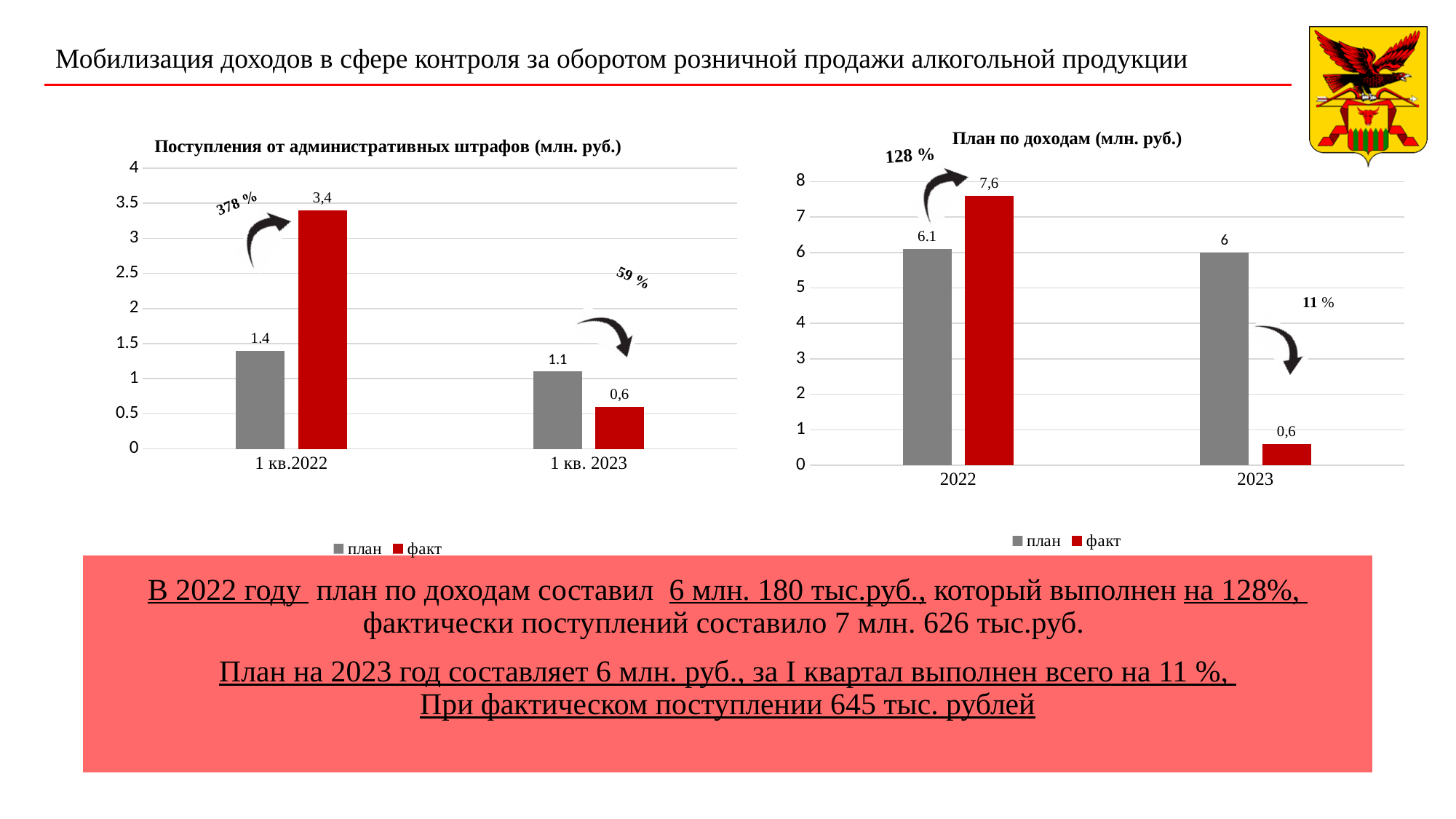
In the chart titled "План по доходам (млн. руб.)", how many categories are shown on the x axis? 2 In the chart titled "Поступления от административных штрафов (млн. руб.)", how many series does the legend list? 2 In the chart titled "План по доходам (млн. руб.)", what is the value of факт for 2022? 7,6 In the chart titled "Поступления от административных штрафов (млн. руб.)", what is the difference between факт and план for 1 кв.2022? 2 In the chart titled "План по доходам (млн. руб.)", what colour are the факт bars? red In the chart titled "План по доходам (млн. руб.)", which bar is the lowest? факт for 2023 In the chart titled "Поступления от административных штрафов (млн. руб.)", what is the value of план for 1 кв. 2023? 1.1 In the chart titled "Поступления от административных штрафов (млн. руб.)", what is the value of факт for 1 кв.2022? 3,4 In the chart titled "План по доходам (млн. руб.)", what is the value of план for 2023? 6 In the chart titled "Поступления от административных штрафов (млн. руб.)", which is larger for 1 кв. 2023, план or факт? план What kind of chart is the chart titled "План по доходам (млн. руб.)"? bar chart In the chart titled "План по доходам (млн. руб.)", what is the difference between план and факт for 2023? 5,4